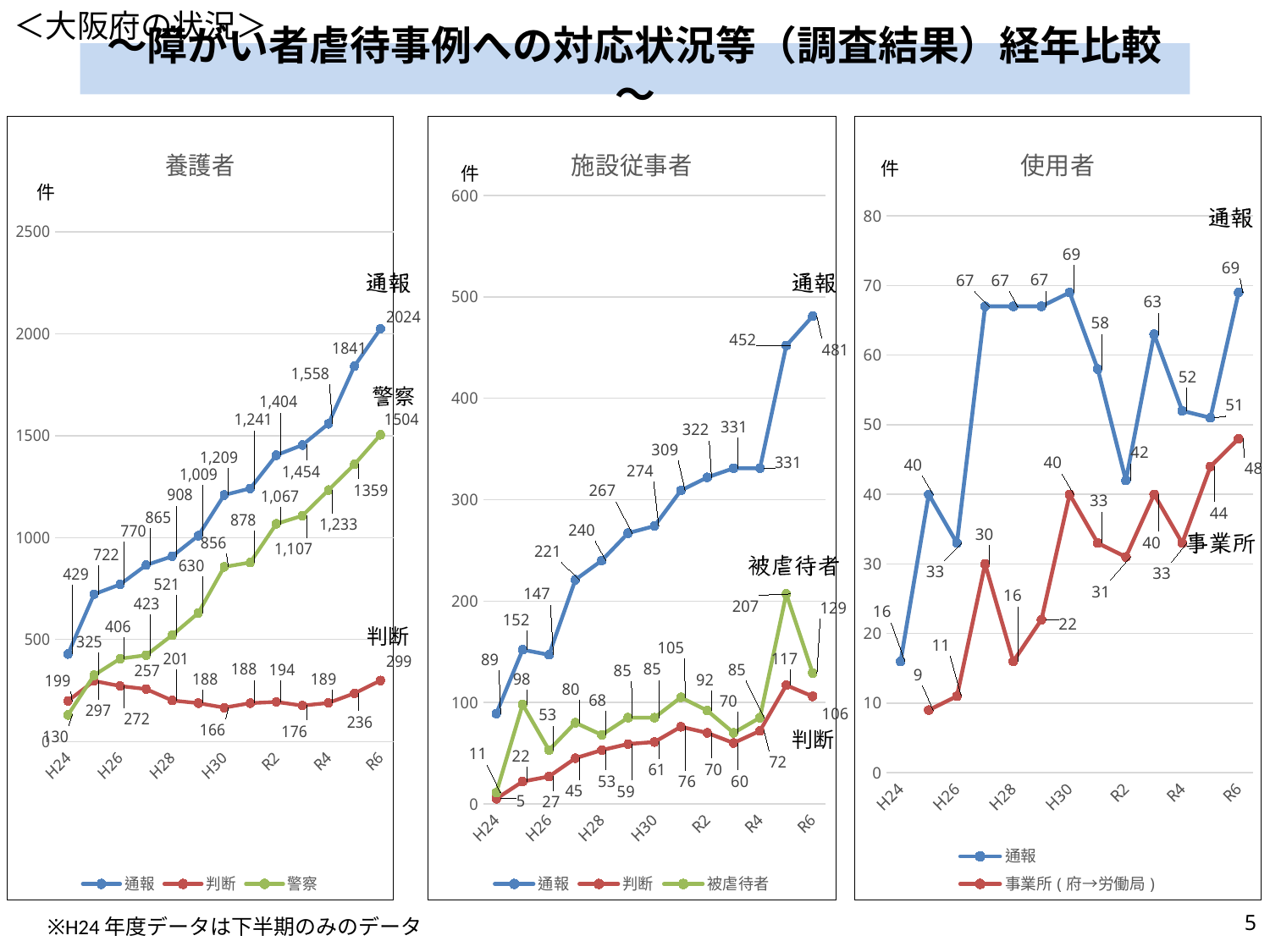
What kind of chart is the 養護者 chart? line chart In the 養護者 chart, what is the 判断 value for R6? 299 In the 施設従事者 chart, what is the highest value reached by the 被虐待者 series? 207 In the 養護者 chart, does the 通報 series generally rise or fall from H24 to R6? rise How many series does the legend of the 養護者 chart list? 3 In the 養護者 chart, what is the 警察 value for R6? 1504 In the 使用者 chart, what is the 通報 value for R6? 69 In the 施設従事者 chart, what is the 通報 value for R6? 481 In the 養護者 chart, what is the 通報 value for H24? 429 In the 養護者 chart, what is the 通報 value for R6? 2024 How many series does the legend of the 使用者 chart list? 2 In the 施設従事者 chart, what is the difference between the 通報 value and the 判断 value for R6? 375